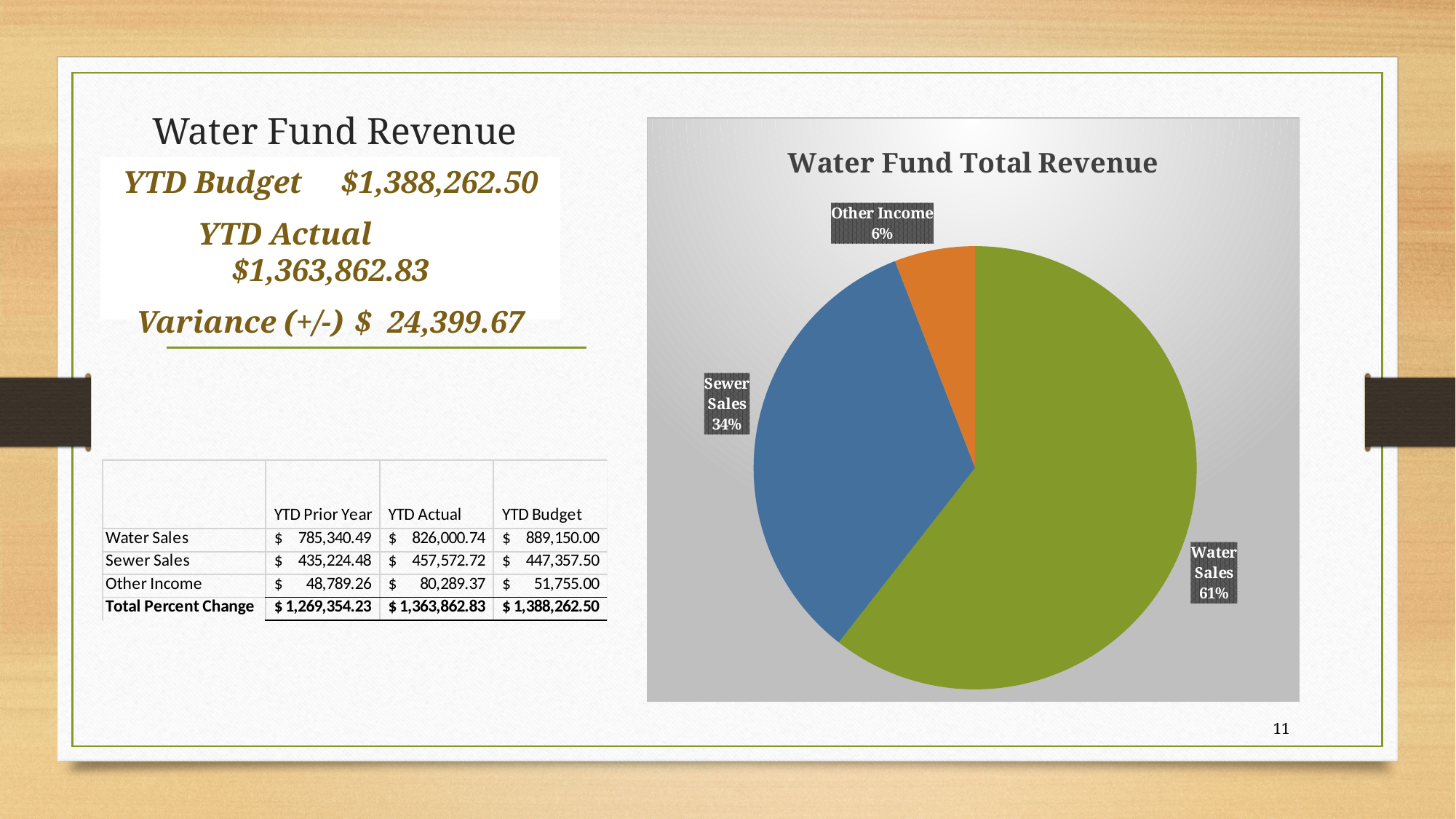
Which category has the smallest slice of the pie? Other Income What kind of chart is shown on the slide? pie chart What colour is the Sewer Sales slice? blue What is the difference in percentage points between the Water Sales and Sewer Sales slices? 27% What share of the pie does Water Sales represent? 61% Which slice is larger, Sewer Sales or Other Income? Sewer Sales What share of the pie does Other Income represent? 6% How many slices does the pie chart have? 3 What is the difference in percentage points between the Sewer Sales and Other Income slices? 28% What is the title of the chart? Water Fund Total Revenue Which category has the largest slice of the pie? Water Sales What share of the pie does Sewer Sales represent? 34%